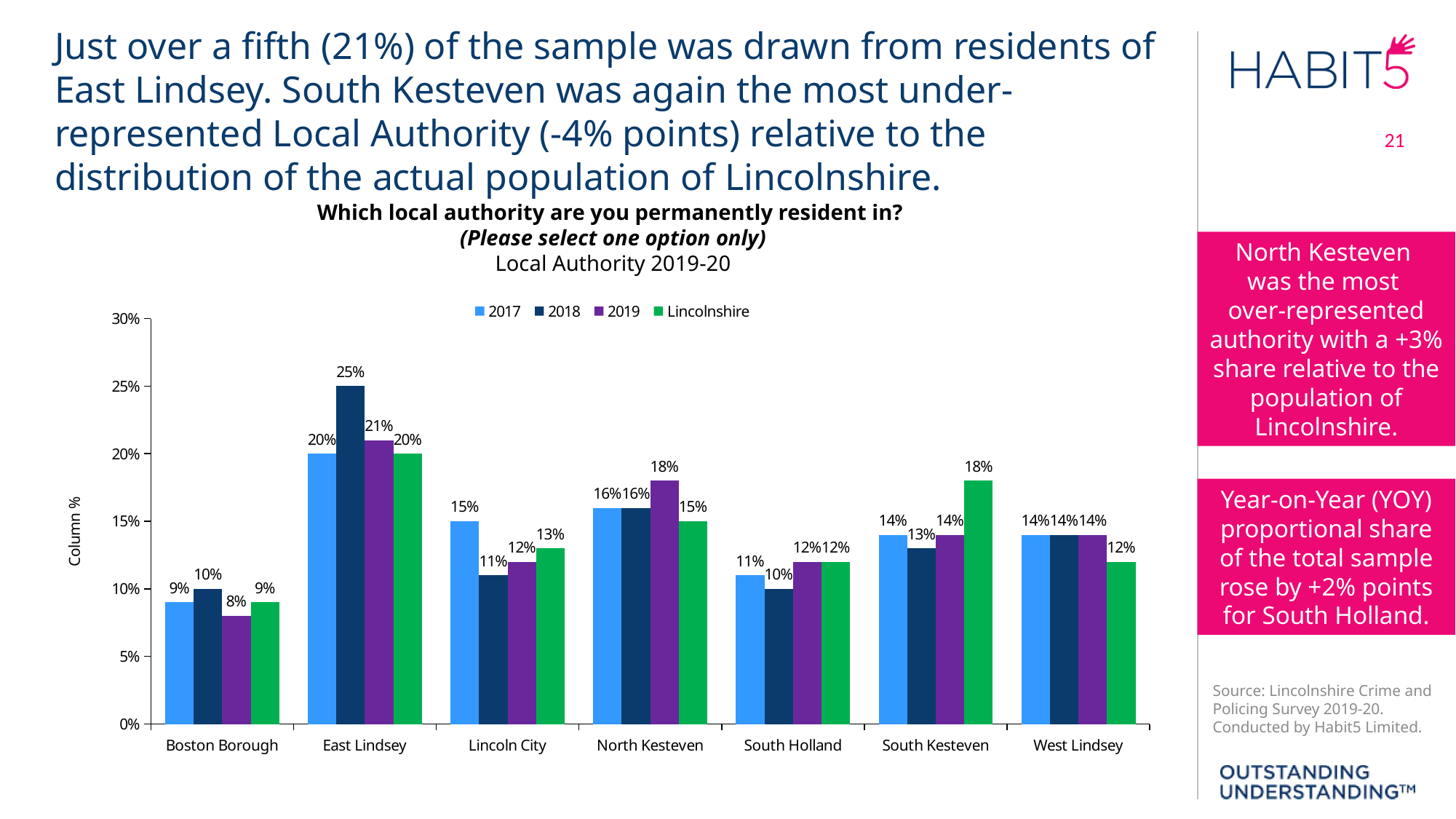
Which is larger for North Kesteven: the 2019 value or the Lincolnshire value? 2019 What is the Lincolnshire value for South Kesteven? 18% How many local authorities are shown on the x axis? 7 What kind of chart is shown on the slide? Bar chart Which local authority has the highest 2018 value? East Lindsey How many series does the legend list? 4 What is the label on the y axis of the chart? Column % Which local authority has the lowest 2019 value? Boston Borough What is the 2018 value for Boston Borough? 10% What is the 2019 value for East Lindsey? 21% What is the difference between the 2019 value and the Lincolnshire value for South Kesteven? 4% What is the difference between the 2018 and 2019 values for South Holland? 2%